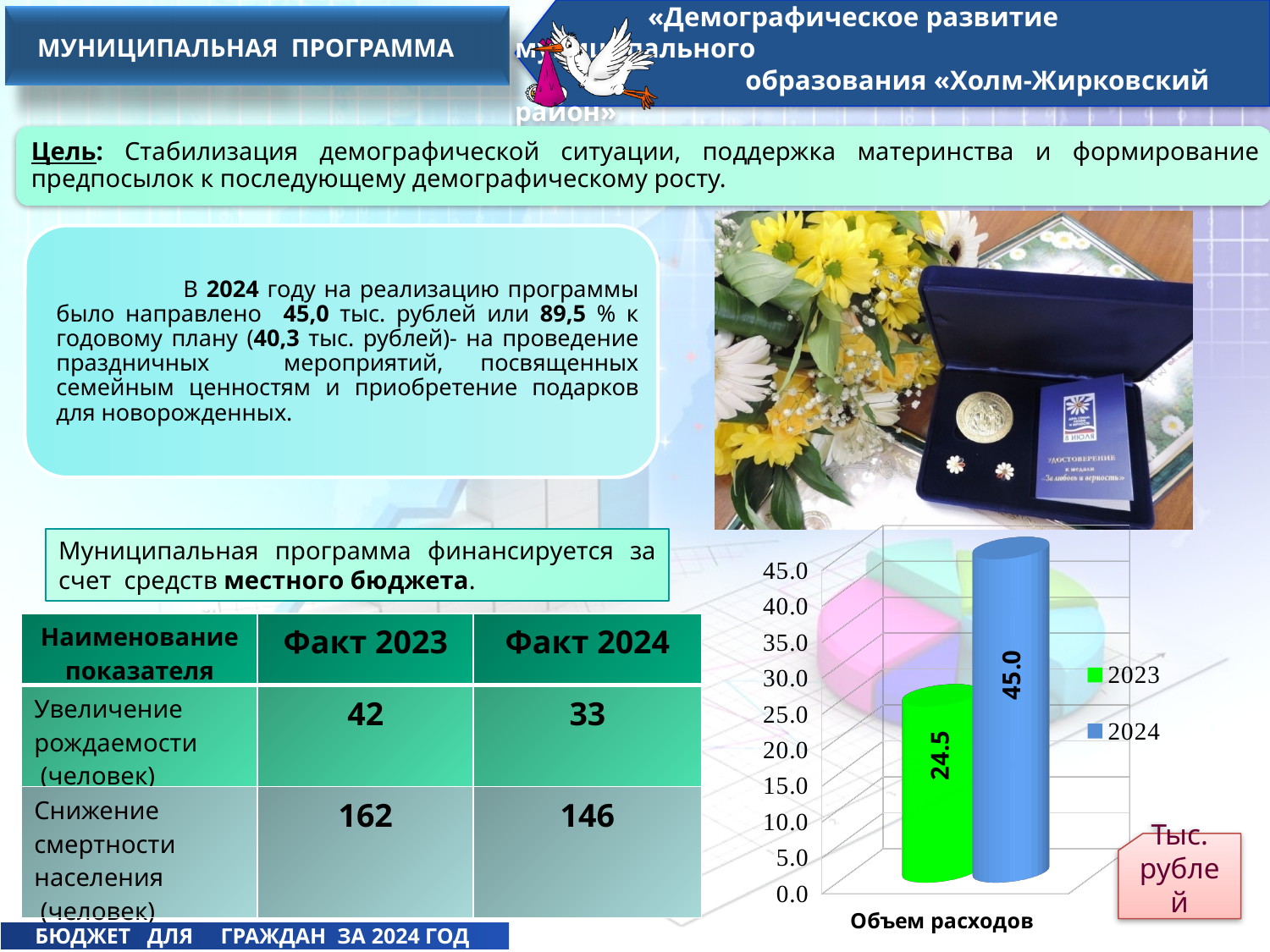
What kind of chart is shown on the slide? bar chart What is the category label on the x axis of the chart? Объем расходов Is the value for 2023 greater or less than 30.0? less What is the value for 2024 in the chart? 45.0 What colour is the 2023 bar in the chart? green What is the difference between the 2024 and 2023 values in the chart? 20.5 Is the value for 2024 greater or less than 40.0? greater Which year has the higher value in the chart, 2023 or 2024? 2024 Which series has the highest value in the chart? 2024 Which series has the lowest value in the chart? 2023 How many series does the chart legend list? 2 What is the value for 2023 in the chart? 24.5